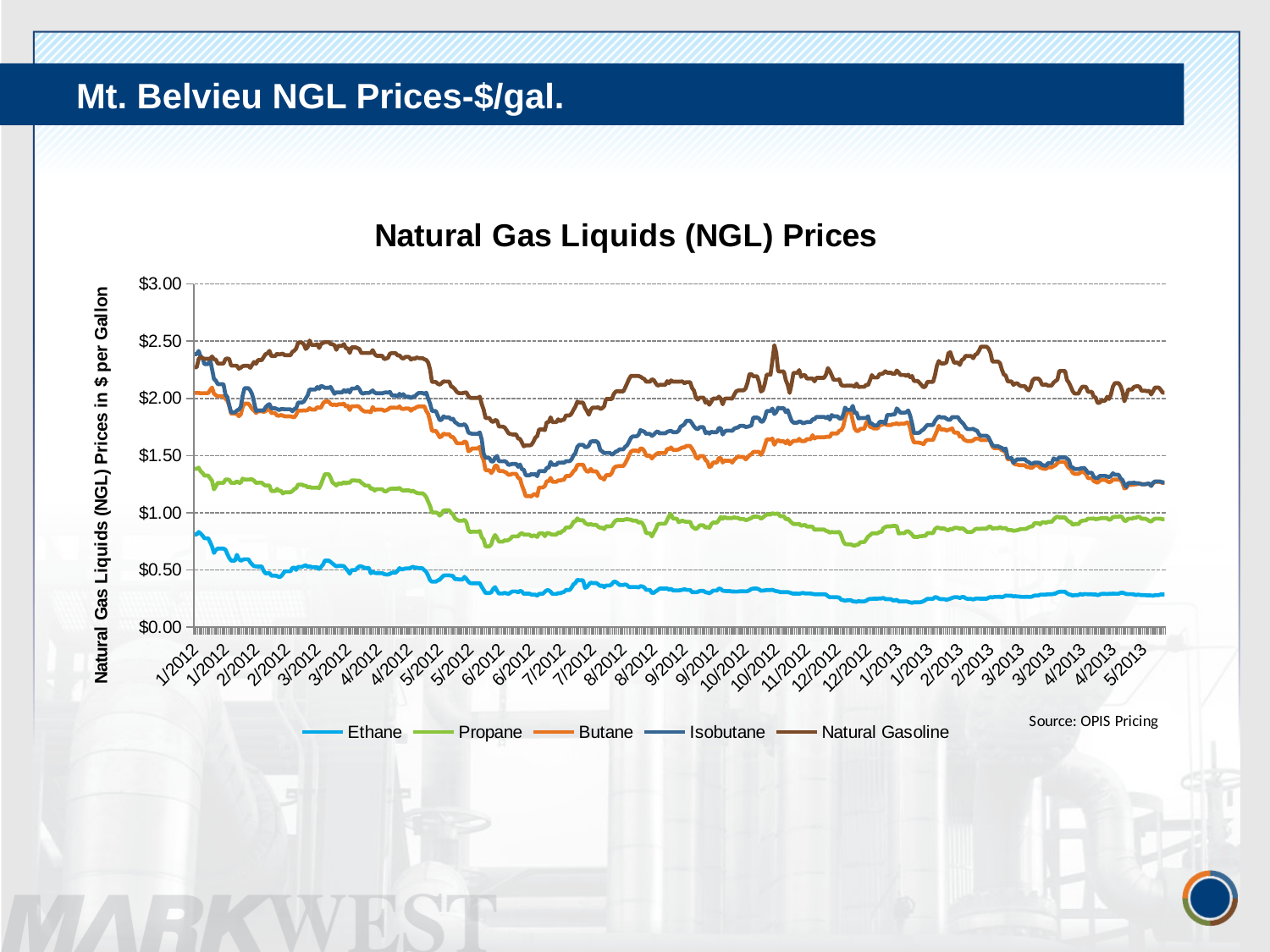
Which series has the highest prices across the chart? Natural Gasoline Is the Ethane price at the start of the chart (1/2012) greater or less than $0.50? greater What kind of chart is shown on the slide? Line chart What is the title of the chart? Natural Gas Liquids (NGL) Prices Is the Ethane price at the end of the chart (5/2013) greater or less than $0.50? less How many series does the legend list? 5 Is the Butane price at the end of the chart (5/2013) greater or less than $1.50? less Which series has the lowest prices across the chart? Ethane Which series is plotted with the brown line? Natural Gasoline Does the Ethane price rise or fall from 1/2012 to 5/2013? fall Which series has the higher price at the end of the chart, Propane or Isobutane? Isobutane